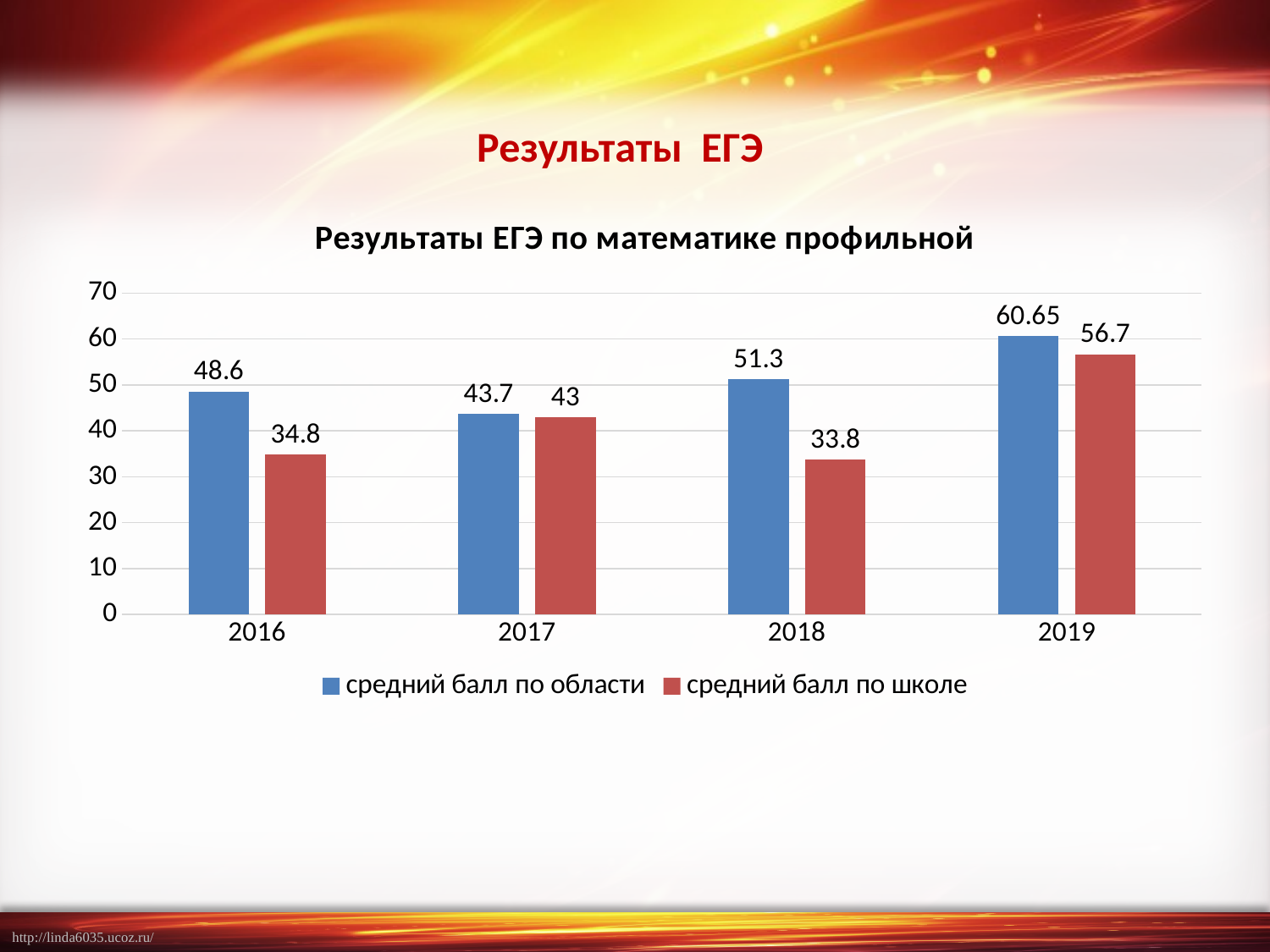
What kind of chart is shown on the slide? bar chart In which year is "средний балл по области" the highest? 2019 What is the value for "средний балл по школе" in 2018? 33.8 What is the difference between "средний балл по области" and "средний балл по школе" in 2016? 13.8 What is the title of the chart? Результаты ЕГЭ по математике профильной What is the value for "средний балл по области" in 2016? 48.6 How many series does the legend list? 2 In which year is "средний балл по школе" the lowest? 2018 What is the value for "средний балл по школе" in 2019? 56.7 Is the value for "средний балл по области" in 2019 greater or less than 60? greater Which is larger in 2017: "средний балл по области" or "средний балл по школе"? средний балл по области How many years are shown on the x axis? 4